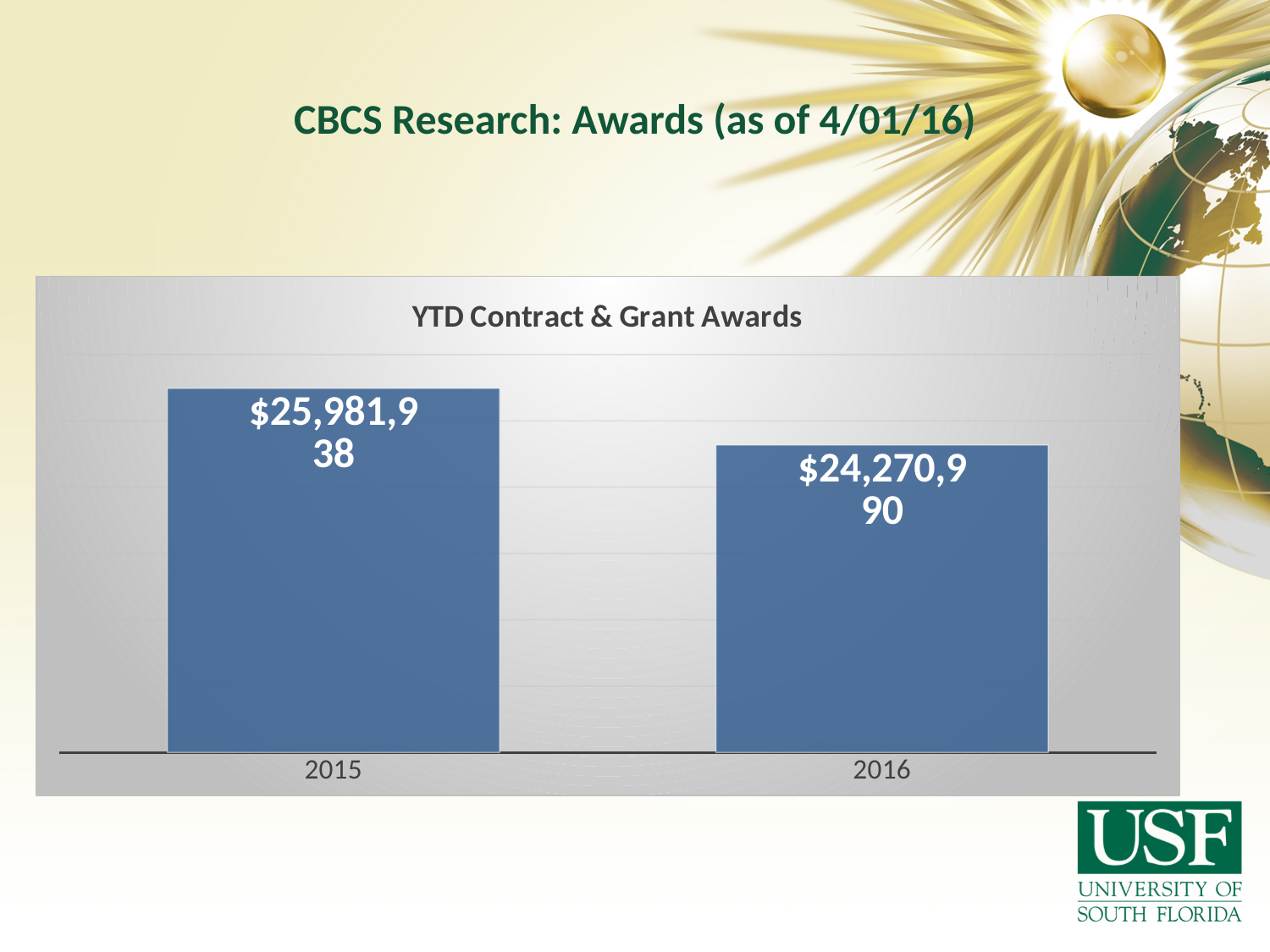
Do the YTD Contract & Grant Awards values rise or fall from 2015 to 2016? Fall How many years are shown in the YTD Contract & Grant Awards chart? 2 What colour are the bars in the YTD Contract & Grant Awards chart? Blue Which is larger, the YTD Contract & Grant Awards value for 2015 or for 2016? 2015 What is the difference between the 2015 and 2016 YTD Contract & Grant Awards values? $1,710,948 What is the value for 2015 in the YTD Contract & Grant Awards chart? $25,981,938 What is the title of the chart on the slide? YTD Contract & Grant Awards Which year has the lowest YTD Contract & Grant Awards value? 2016 What is the value for 2016 in the YTD Contract & Grant Awards chart? $24,270,990 Which year has the highest YTD Contract & Grant Awards value? 2015 What kind of chart is used to show YTD Contract & Grant Awards? Bar chart